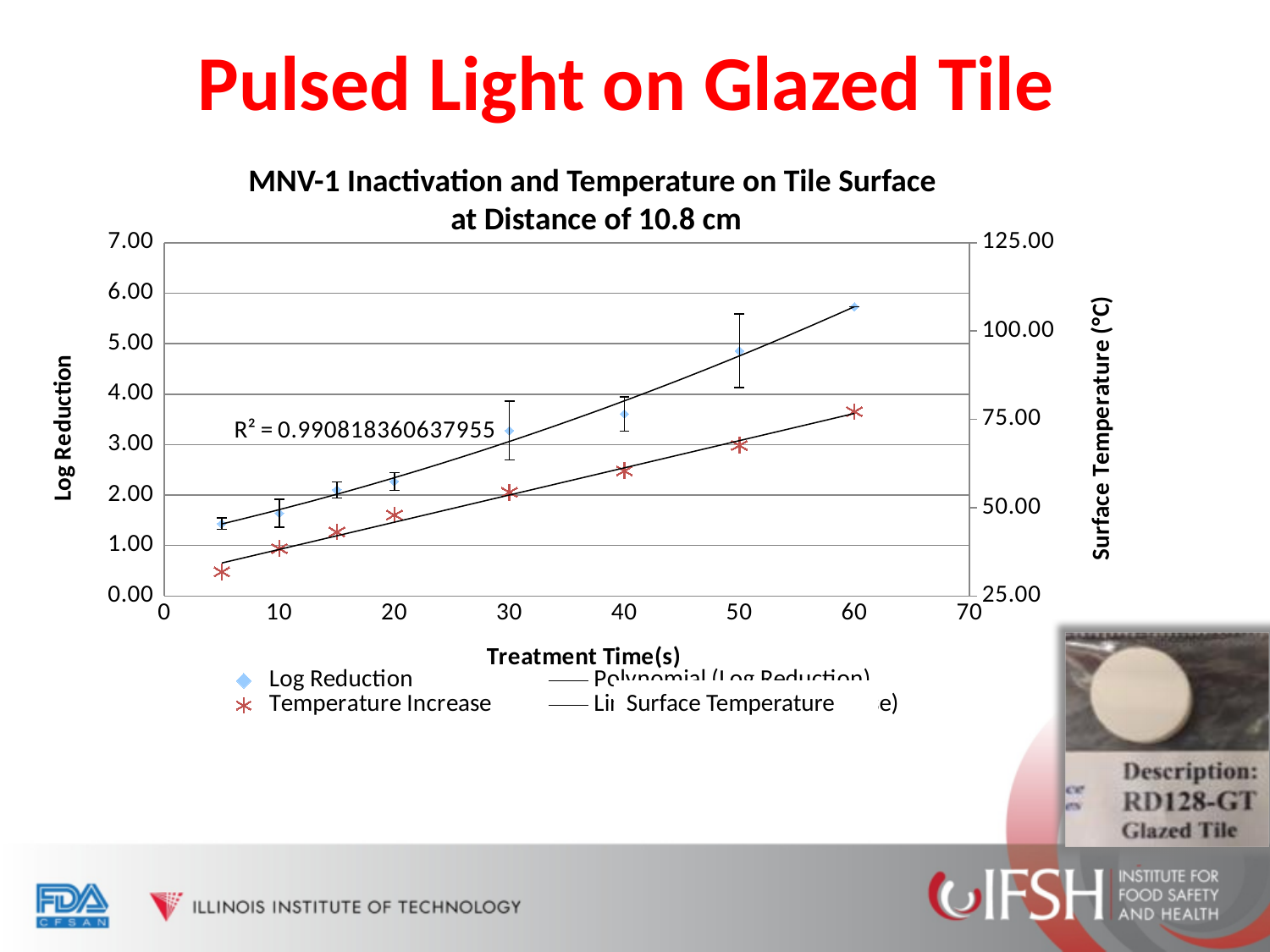
Is the Log Reduction at 5 s greater or less than 2.00? less Is the Temperature Increase value at 50 s greater or less than 50.00 °C? greater At which treatment time is the Log Reduction lowest? 5 Do the Log Reduction values rise or fall as treatment time increases? rise How many Log Reduction data points are plotted? 8 At which treatment time is the Log Reduction highest? 60 What kind of chart is shown on the slide? Scatter chart Is the Temperature Increase value at 5 s greater or less than 50.00 °C? less What is the title of the chart? MNV-1 Inactivation and Temperature on Tile Surface at Distance of 10.8 cm What is the R² value printed on the chart? 0.990818360637955 What is the label of the left vertical axis? Log Reduction